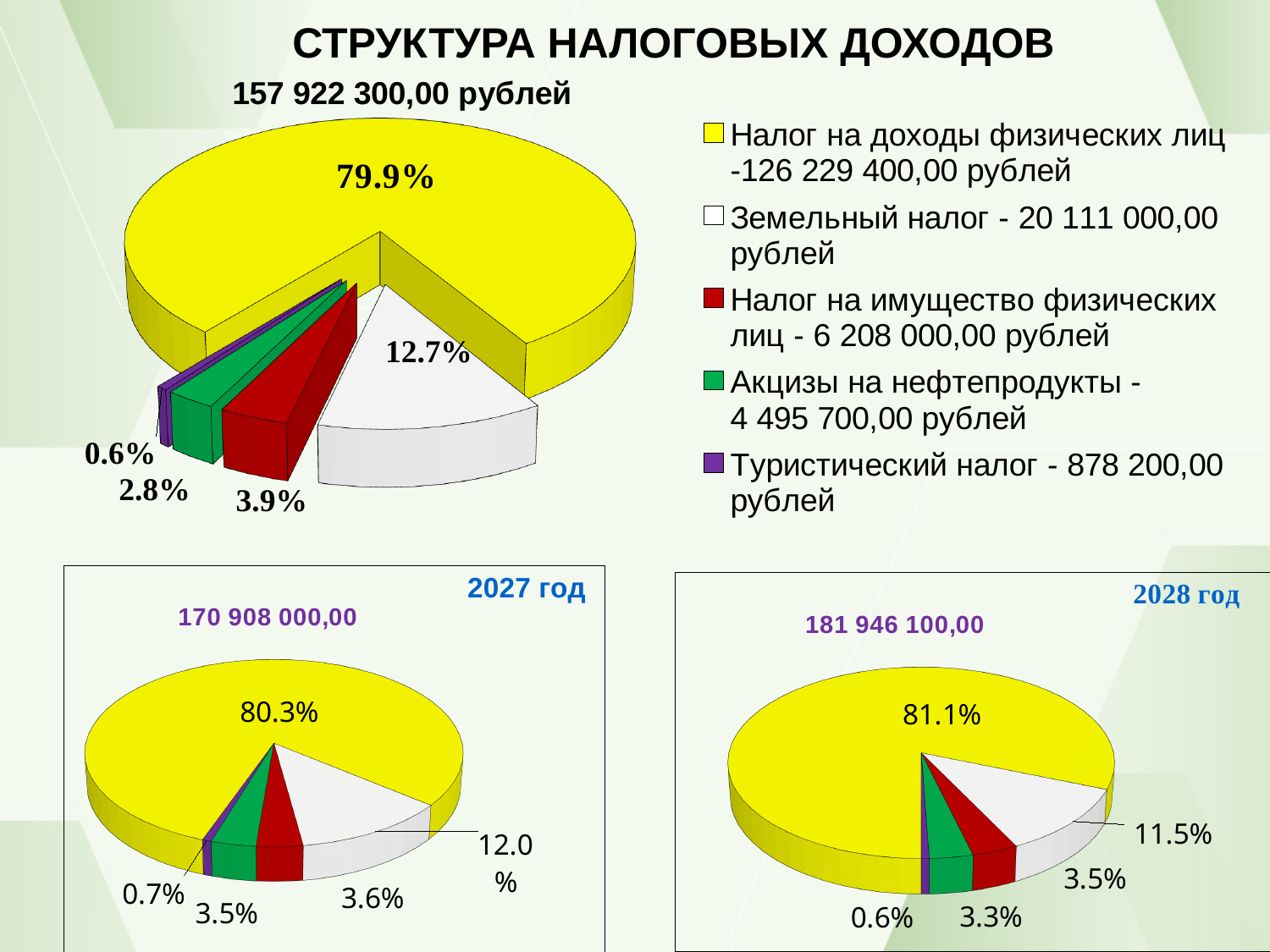
What total amount is shown in the 2028 год pie chart? 181 946 100,00 In the top pie chart, which category has the largest share? Налог на доходы физических лиц What total amount is shown above the top pie chart? 157 922 300,00 рублей In the top pie chart, what share is shown for Туристический налог? 0.6% In the top pie chart, what share is shown for Налог на доходы физических лиц? 79.9% What type of chart is used on this slide? pie chart In the 2028 год pie chart, what share is shown for the white slice? 11.5% In the top pie chart, which category has the smallest share? Туристический налог According to the legend of the top pie chart, what is the amount for Акцизы на нефтепродукты? 4 495 700,00 рублей How many categories does the legend of the top pie chart list? 5